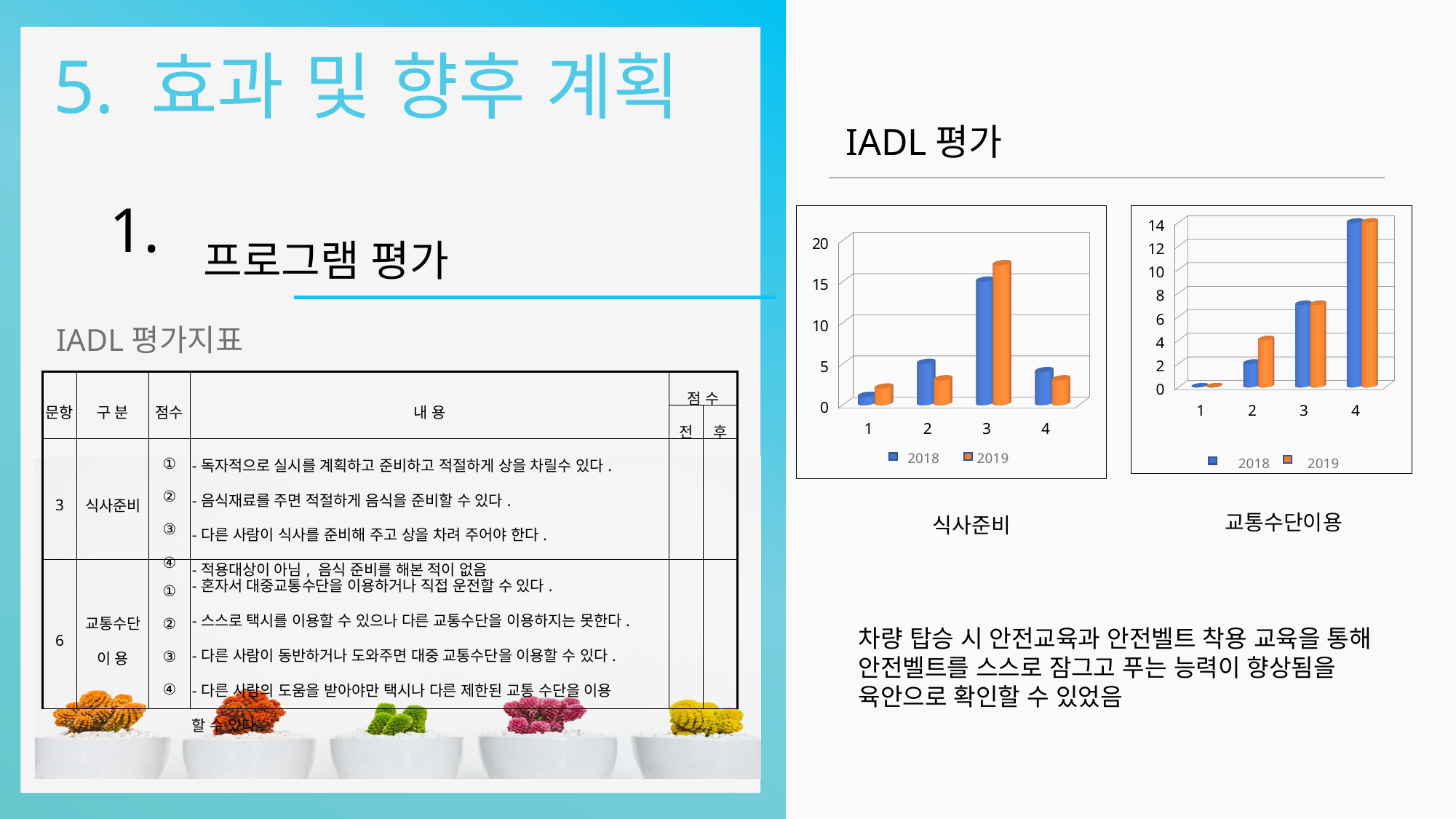
In the 식사준비 chart, which category has the highest 2019 value? 3 What kind of chart is the 식사준비 chart? bar chart In the 식사준비 chart, for category 2, which series has the larger value, 2018 or 2019? 2018 In the 교통수단이용 chart, is the 2019 value for category 4 greater or less than 12? greater In the 교통수단이용 chart, which category has the lowest 2019 value? 1 How many series does the legend of the 교통수단이용 chart list? 2 What are the two legend entries in the 식사준비 chart? 2018 and 2019 How many categories are shown on the x axis of the 식사준비 chart? 4 In the 교통수단이용 chart, which category has the highest 2018 value? 4 In the 식사준비 chart, which category has the lowest 2018 value? 1 In the 식사준비 chart, is the 2019 value for category 3 greater or less than 15? greater In the 교통수단이용 chart, for category 2, which series has the larger value, 2018 or 2019? 2019